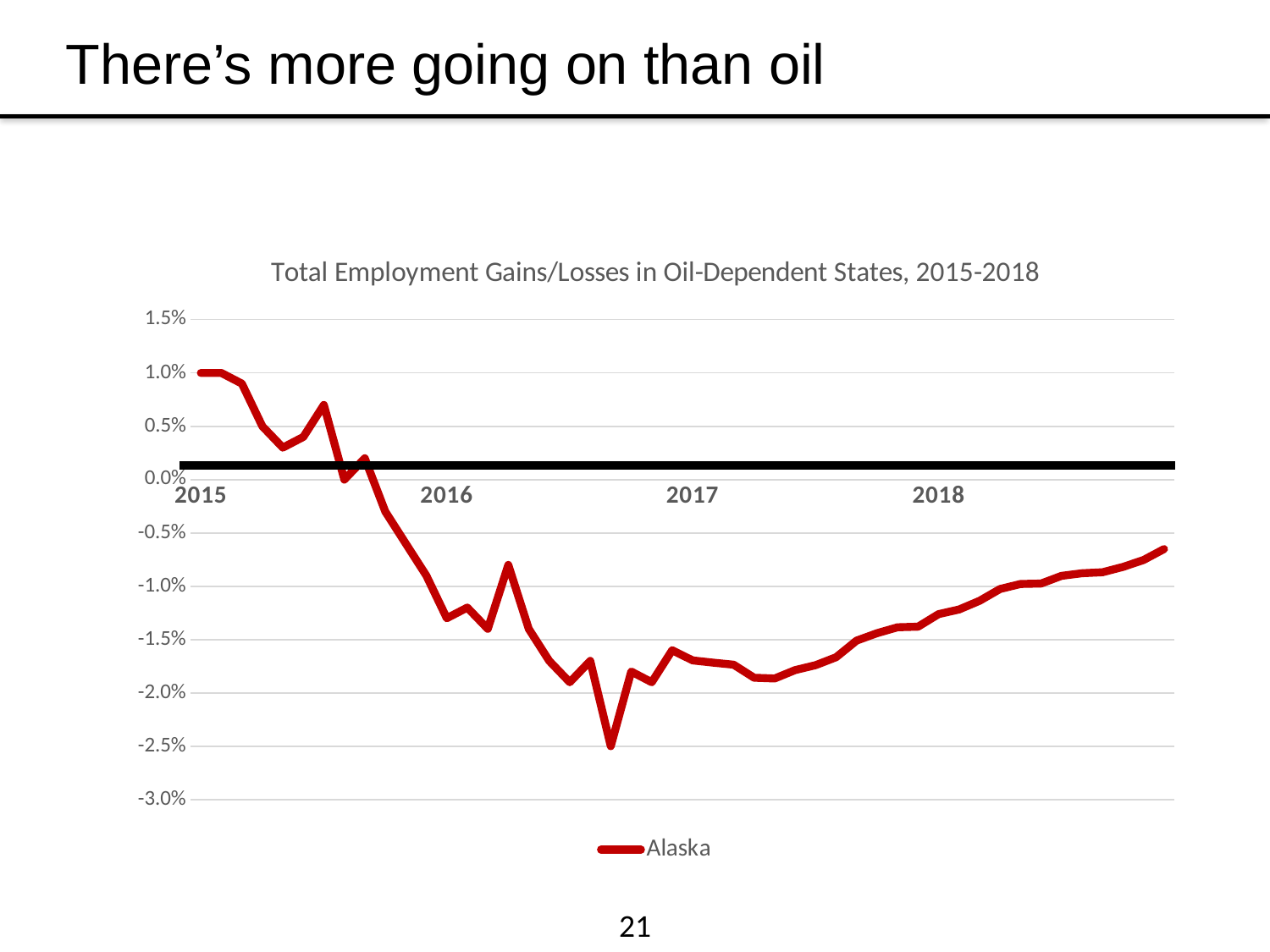
How many series does the chart legend list? 1 Is the value for Alaska at the 2016 label greater or less than -1.0%? less In which year does the Alaska line reach its highest point? 2015 How many year labels are shown on the x axis? 4 In which year does the Alaska line reach its lowest point? 2016 What kind of chart is shown on the slide? line chart Is the value for Alaska at the 2015 label higher or lower than at the 2017 label? higher Which series is named in the chart legend? Alaska Is the value for Alaska at the 2017 label greater or less than -1.5%? less Does the Alaska line rise or fall between the 2017 label and the end of the chart? rise Does the Alaska line rise or fall between the 2015 and 2016 labels on the x axis? fall What is the title of the chart? Total Employment Gains/Losses in Oil-Dependent States, 2015-2018